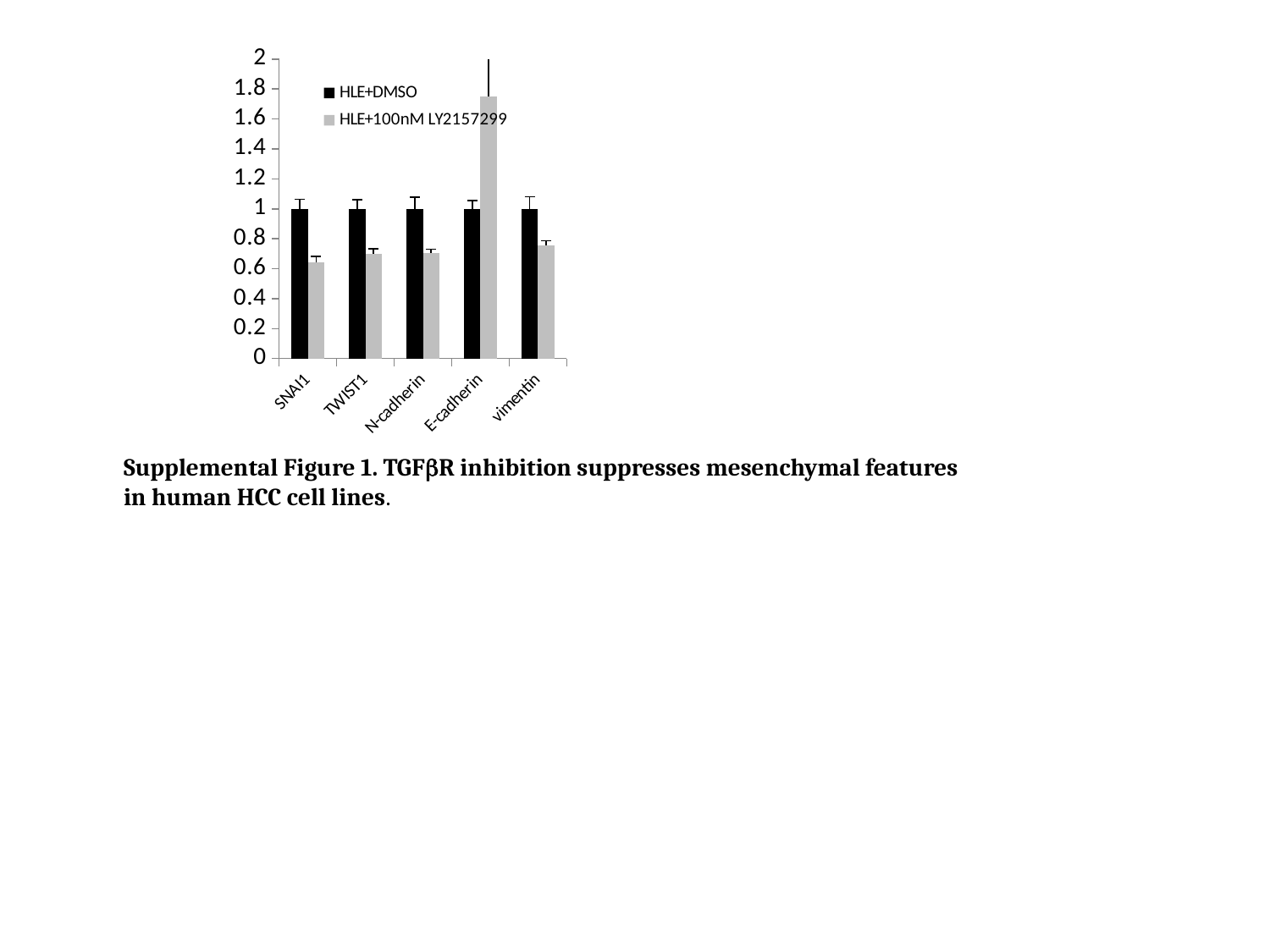
How many categories are shown on the x axis of the chart? 5 For TWIST1, which series has the larger value, HLE+DMSO or HLE+100nM LY2157299? HLE+DMSO For which category is the HLE+100nM LY2157299 value highest? E-cadherin What is the value of HLE+DMSO for E-cadherin? 1 Which colour represents the HLE+DMSO series in the chart? black Is the HLE+100nM LY2157299 value for SNAI1 greater or less than 0.8? less What is the value of HLE+DMSO for SNAI1? 1 Is the HLE+100nM LY2157299 value for E-cadherin greater or less than 1.4? greater What kind of chart is shown on the slide? bar chart How many series does the chart's legend list? 2 For E-cadherin, which series has the larger value, HLE+DMSO or HLE+100nM LY2157299? HLE+100nM LY2157299 Is the HLE+100nM LY2157299 value for vimentin greater or less than 1? less